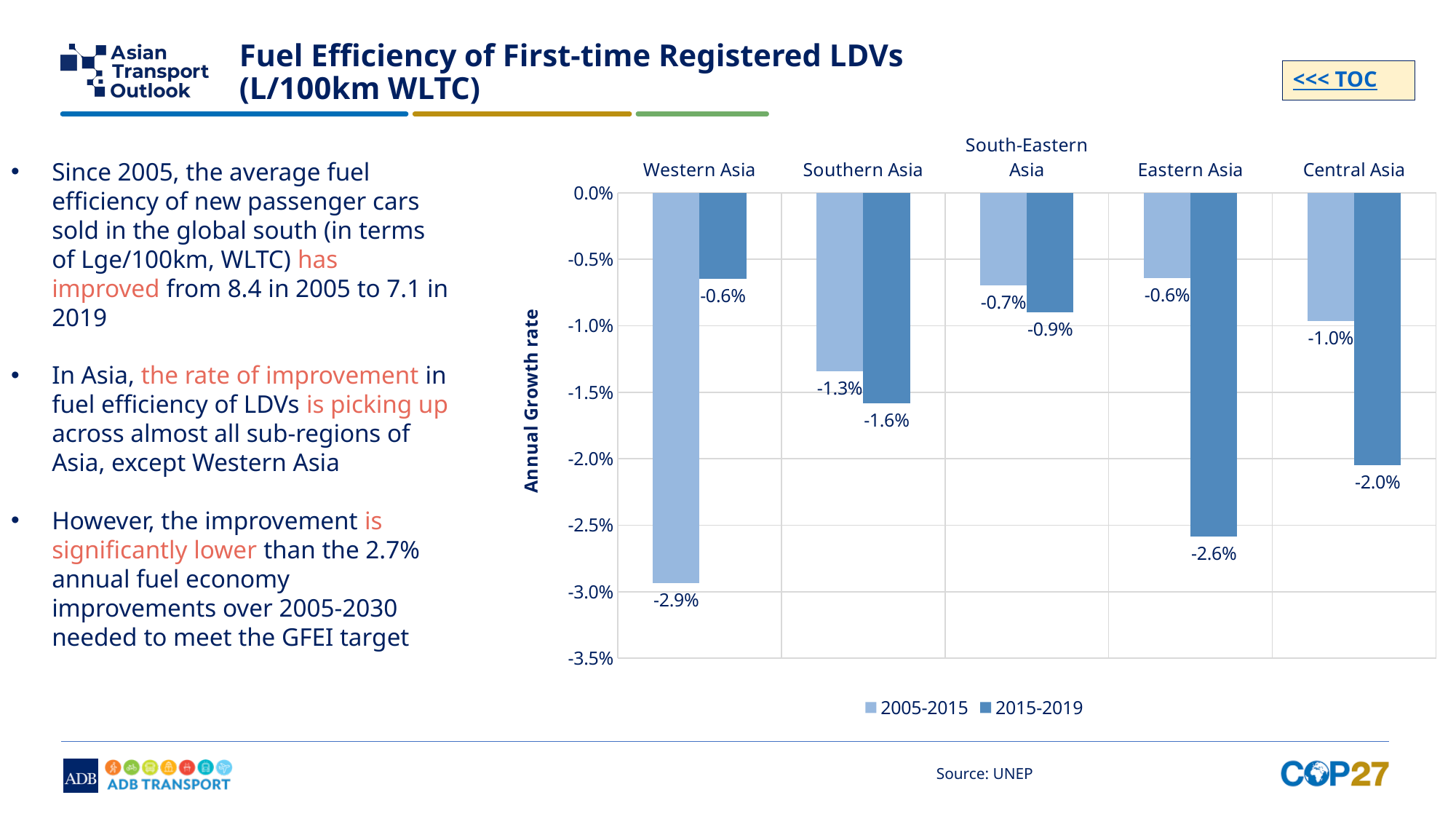
Which sub-region has the most negative annual growth rate in the 2015-2019 series? Eastern Asia What is the annual growth rate for Eastern Asia in the 2015-2019 series? -2.6% What is the annual growth rate for South-Eastern Asia in the 2005-2015 series? -0.7% What is the annual growth rate for Central Asia in the 2015-2019 series? -2.0% Which sub-region has the annual growth rate closest to zero in the 2015-2019 series? Western Asia How many series does the chart legend list? 2 Which is larger, the 2015-2019 value for Southern Asia or the 2015-2019 value for Central Asia? Southern Asia (-1.6%) What is the annual growth rate for Western Asia in the 2005-2015 series? -2.9% Which sub-region has the most negative annual growth rate in the 2005-2015 series? Western Asia What is the title of the vertical axis of the chart? Annual Growth rate How many sub-regions are shown on the x axis of the chart? 5 By how many percentage points does the Eastern Asia 2015-2019 value differ from its 2005-2015 value? 2.0 percentage points